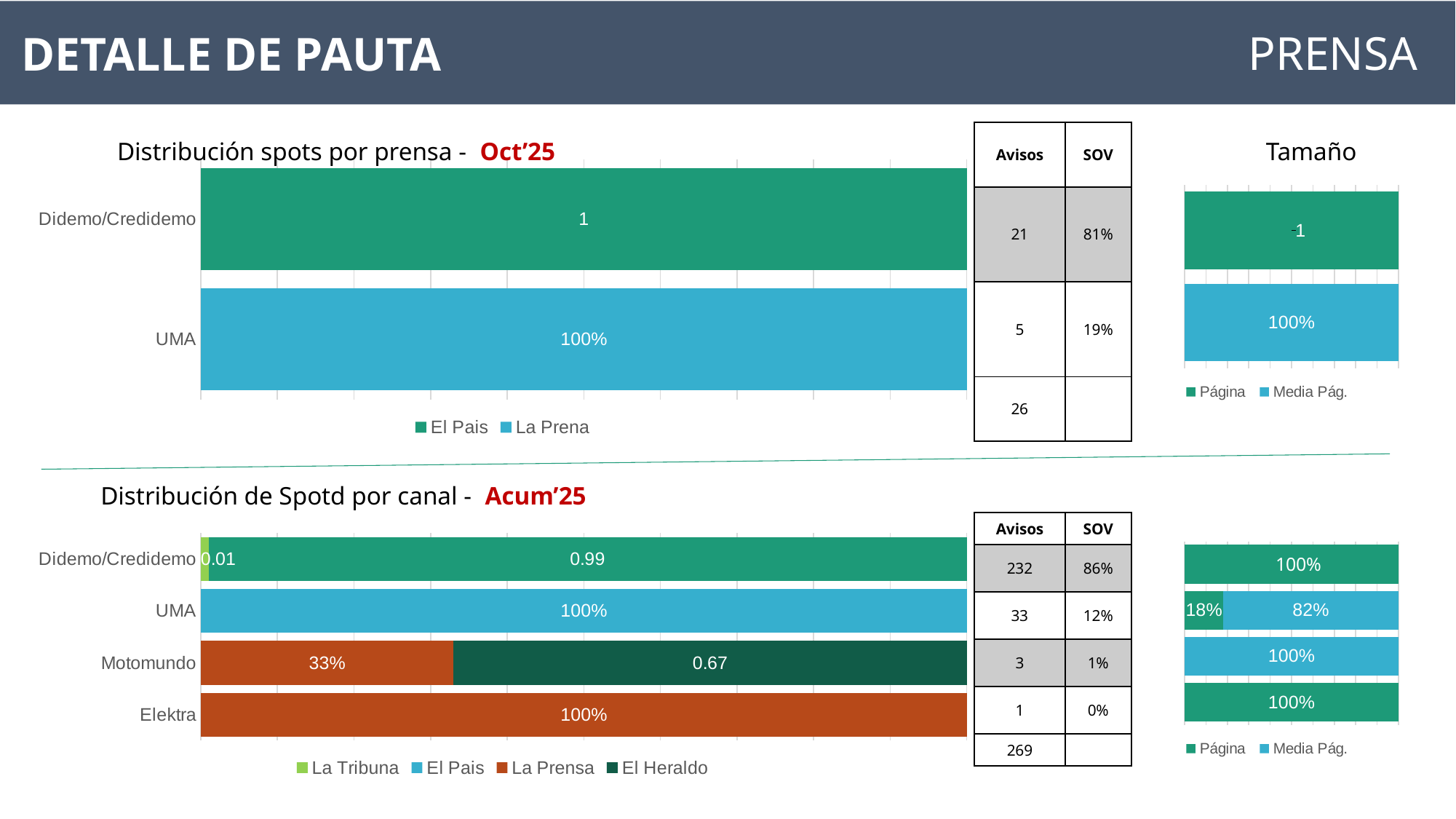
In the 'Distribución de Spotd por canal - Acum'25' chart, what is the La Prensa value for Motomundo? 33% In the 'Distribución de Spotd por canal - Acum'25' chart, what is the El Heraldo value for Motomundo? 0.67 In the 'Distribución spots por prensa - Oct'25' chart, what value is labelled on the UMA bar? 100% In the 'Distribución spots por prensa - Oct'25' chart, how many series does the legend list? 2 In the Tamaño chart at the bottom right of the slide, what is the Media Pág. value for UMA? 82% In the 'Distribución spots por prensa - Oct'25' chart, how many categories are shown on the vertical axis? 2 In the 'Distribución de Spotd por canal - Acum'25' chart, how many categories are shown on the vertical axis? 4 In the 'Distribución de Spotd por canal - Acum'25' chart, which segment of the Motomundo bar is larger, La Prensa or El Heraldo? El Heraldo What kind of chart is 'Distribución spots por prensa - Oct'25'? bar chart In the 'Distribución de Spotd por canal - Acum'25' chart, how many series does the legend list? 4 In the 'Distribución de Spotd por canal - Acum'25' chart, what is the La Tribuna value for Didemo/Credidemo? 0.01 In the Tamaño chart at the bottom right of the slide, what is the Página value for UMA? 18%